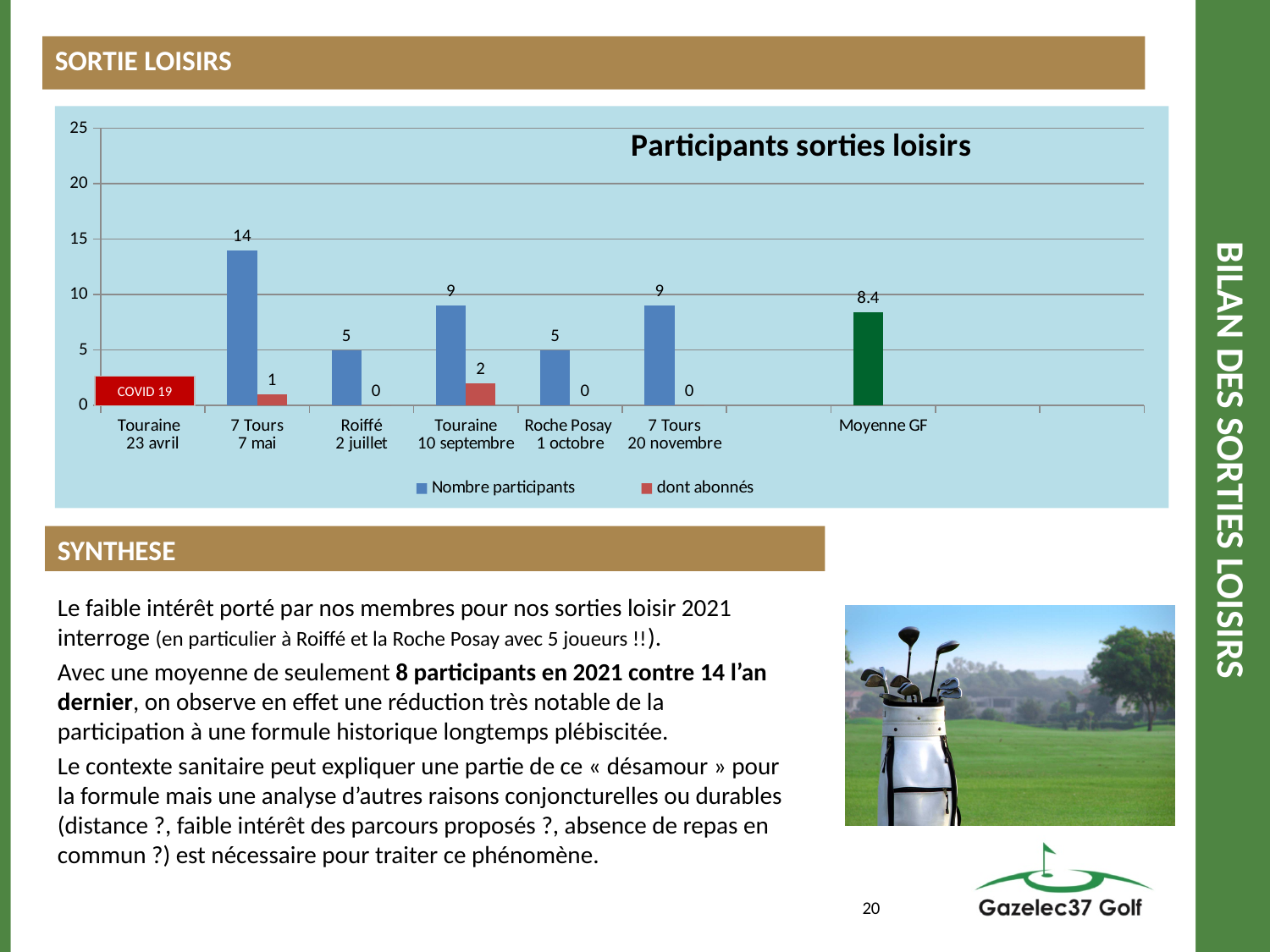
What is the value shown for Moyenne GF? 8.4 What is the title of the chart? Participants sorties loisirs What is the value of 'Nombre participants' for Roche Posay 1 octobre? 5 What is the value of 'dont abonnés' for Touraine 10 septembre? 2 What type of chart is shown on the slide? bar chart What is the value of 'dont abonnés' for 7 Tours 20 novembre? 0 Which is larger: 'Nombre participants' for Touraine 10 septembre or for Roche Posay 1 octobre? Touraine 10 septembre What is the value of 'Nombre participants' for 7 Tours 7 mai? 14 How many series does the chart legend list? 2 Which outing has the highest number of participants ('Nombre participants')? 7 Tours 7 mai What label is shown in place of bars for Touraine 23 avril? COVID 19 What is the difference in 'Nombre participants' between 7 Tours 7 mai and Roiffé 2 juillet? 9